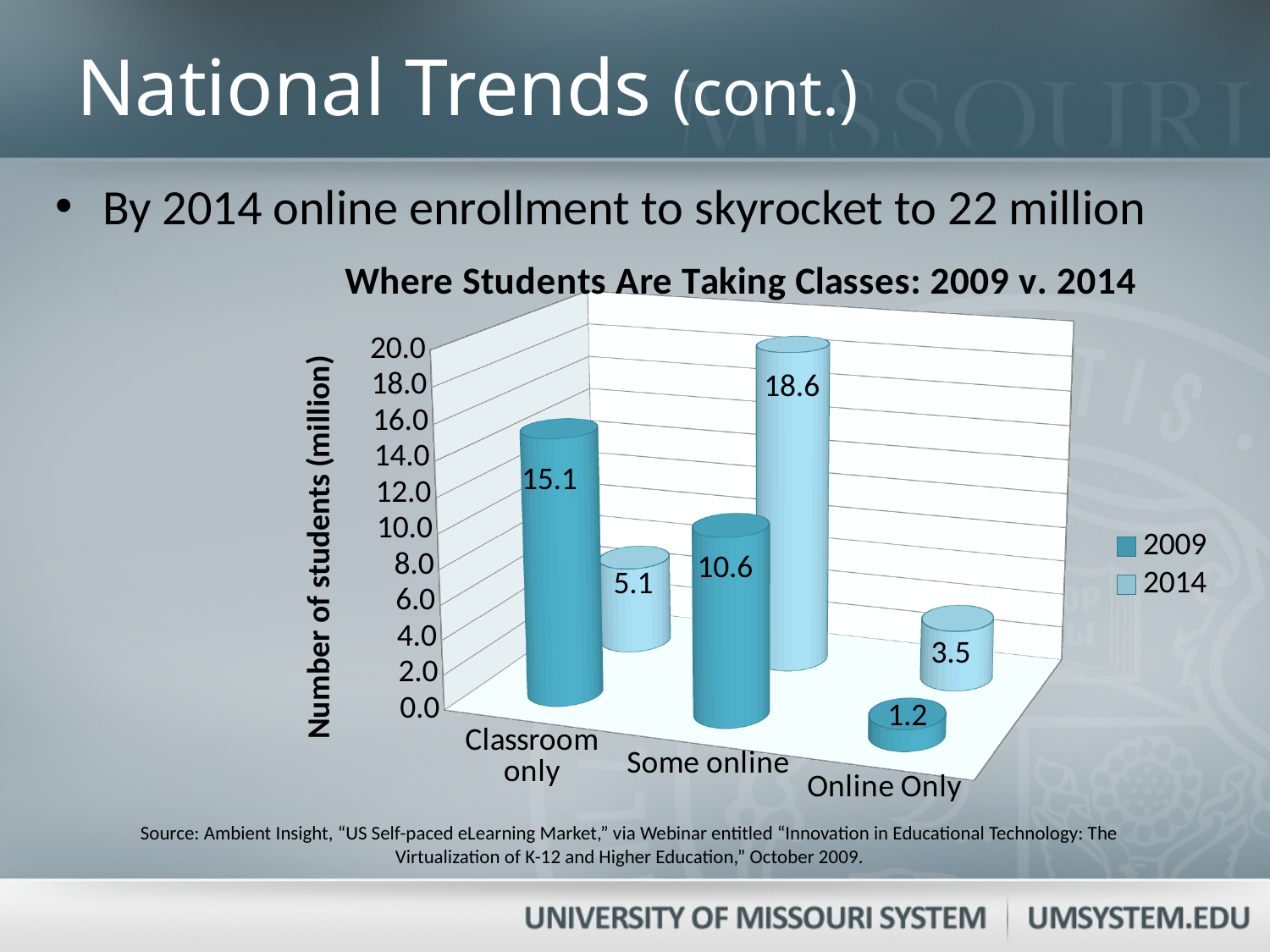
What is the title of the chart? Where Students Are Taking Classes: 2009 v. 2014 How many series does the legend list? 2 What kind of chart is shown? Bar chart Which category has the highest 2014 value? Some online What is the 2014 value for Some online? 18.6 Which is larger: the 2014 value for Online Only or the 2009 value for Online Only? 2014 What is the 2009 value for Online Only? 1.2 What is the difference between the 2009 and 2014 values for Classroom only? 10.0 Which category has the lowest 2009 value? Online Only What is the 2014 value for Classroom only? 5.1 What is the 2009 value for Classroom only? 15.1 How many categories are shown on the x axis? 3